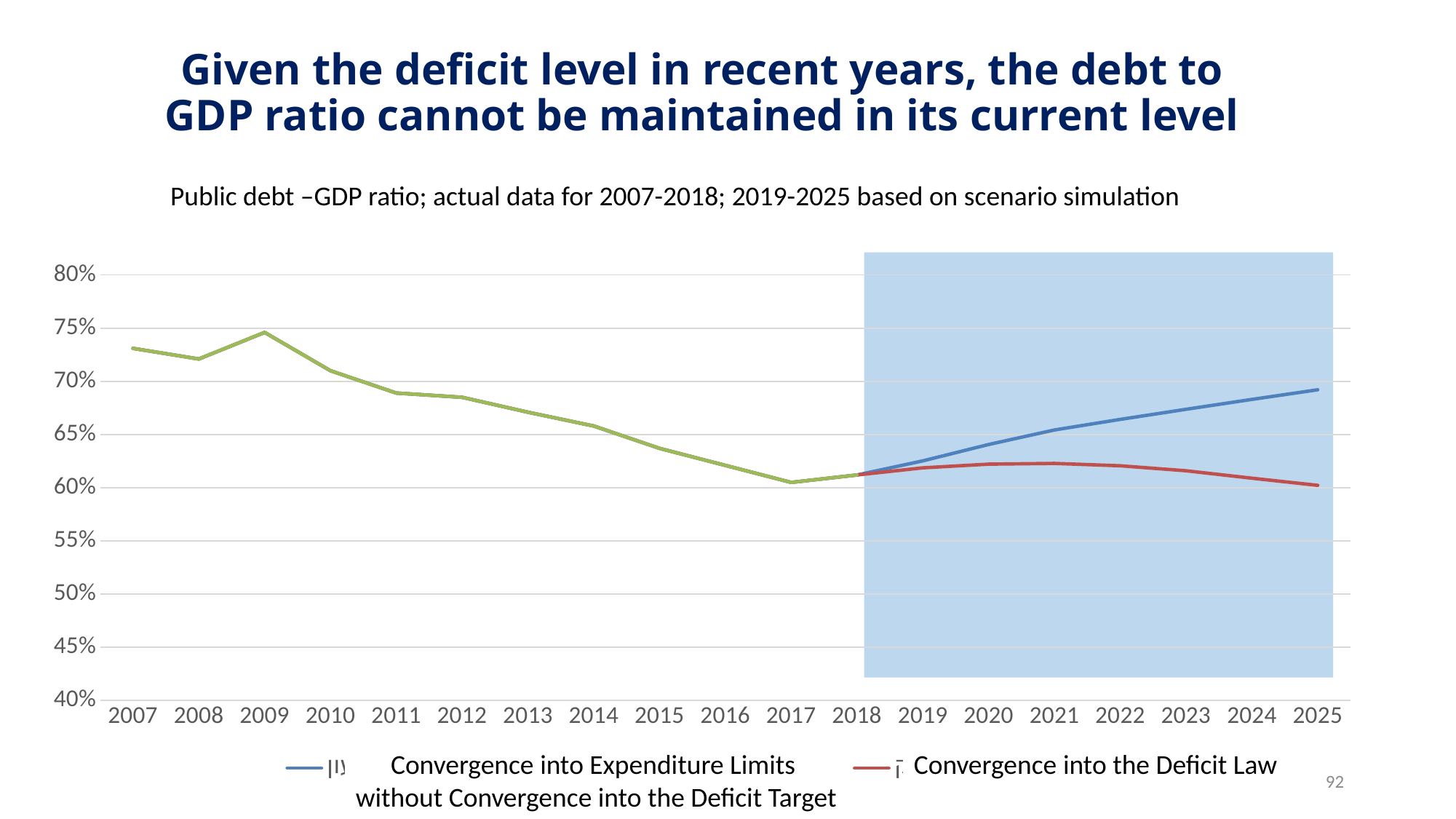
Is the debt to GDP ratio in 2009 greater or less than 70%? greater How many years are shown on the x axis? 19 Is the 2025 value for 'Convergence into the Deficit Law' greater or less than 65%? less What kind of chart is shown on the slide? line chart How many series does the legend list? 2 Is the debt to GDP ratio in 2017 greater or less than 65%? less Does the debt to GDP ratio rise or fall from 2009 to 2017? fall In 2025, which series has the higher debt to GDP ratio: 'Convergence into Expenditure Limits without Convergence into the Deficit Target' or 'Convergence into the Deficit Law'? Convergence into Expenditure Limits without Convergence into the Deficit Target Which years does the chart subtitle say are based on scenario simulation? 2019-2025 Which year between 2007 and 2018 has the highest public debt to GDP ratio? 2009 Which year between 2007 and 2018 has the lowest public debt to GDP ratio? 2017